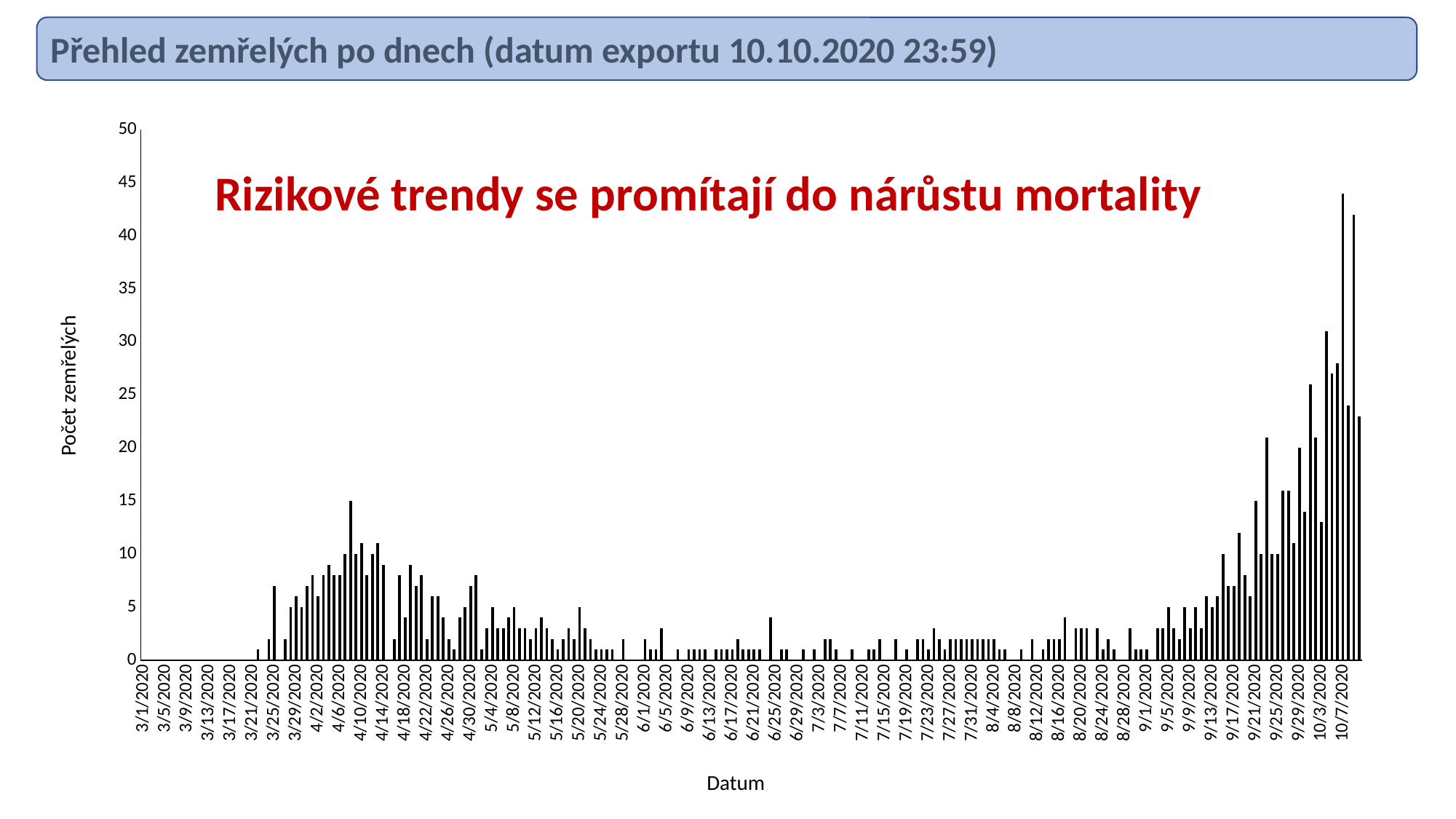
What is the label of the vertical axis? Počet zemřelých Do the values generally rise or fall from mid-April to June 2020? fall Is the highest value in April 2020 greater or less than 20? less Is the highest value in August 2020 greater or less than 5? less In which month does the highest bar of the chart occur? October 2020 What is the label of the horizontal axis? Datum Do the values generally rise or fall from the beginning of September to early October 2020? rise Is the highest value in July 2020 greater or less than 5? less How many data series are plotted in the chart? 1 What kind of chart is shown on the slide? bar chart